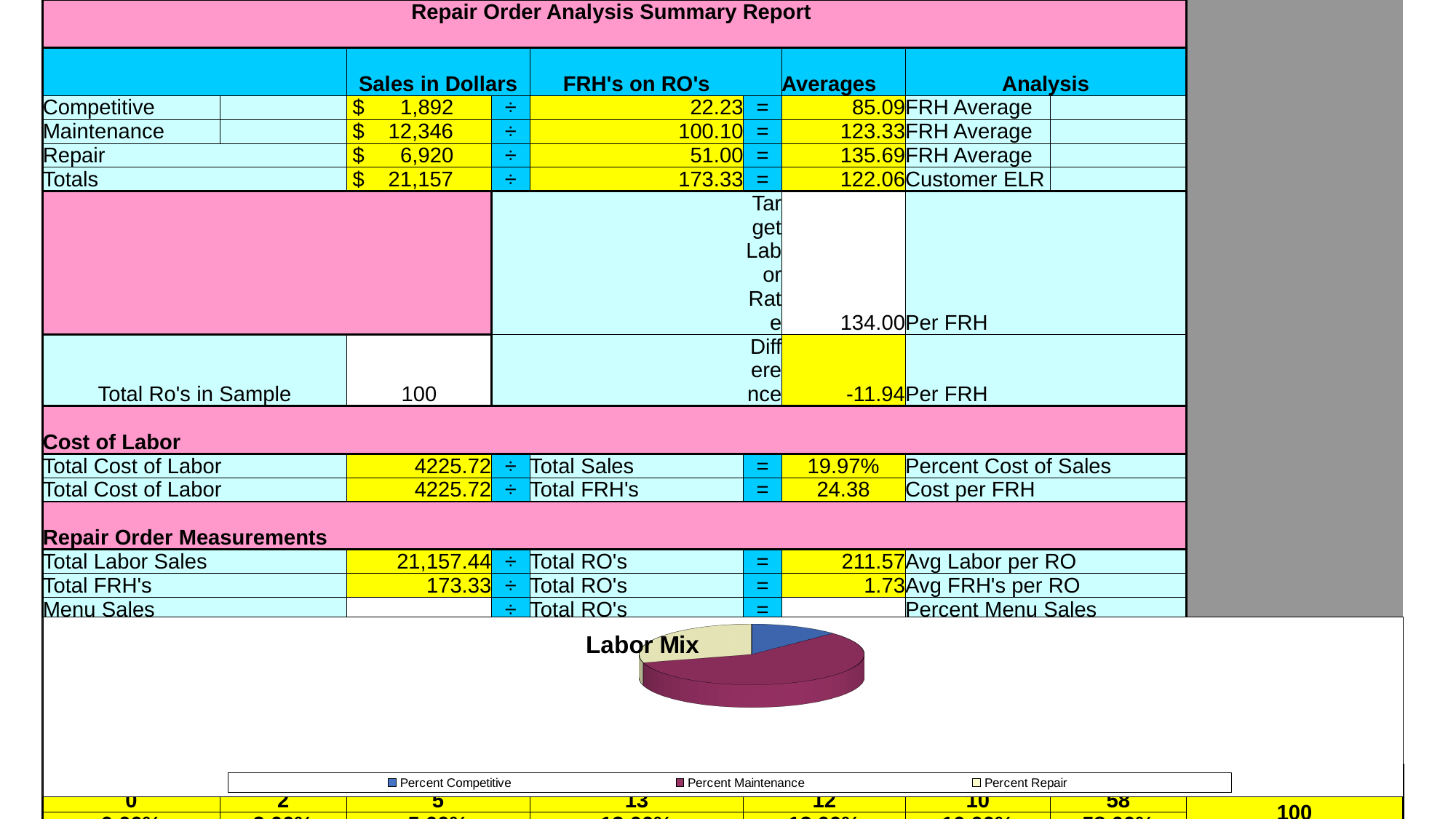
In the Labor Mix pie chart, which is larger: Percent Maintenance or Percent Repair? Percent Maintenance In the Labor Mix pie chart, which is larger: Percent Repair or Percent Competitive? Percent Repair How many entries does the legend of the Labor Mix chart list? 3 What is the title of the chart on the slide? Labor Mix Which legend entry of the Labor Mix chart is shown in blue? Percent Competitive How many slices does the Labor Mix pie chart have? 3 What kind of chart is the Labor Mix chart? pie chart Which slice of the Labor Mix pie chart is the largest? Percent Maintenance Which slice of the Labor Mix pie chart is the smallest? Percent Competitive